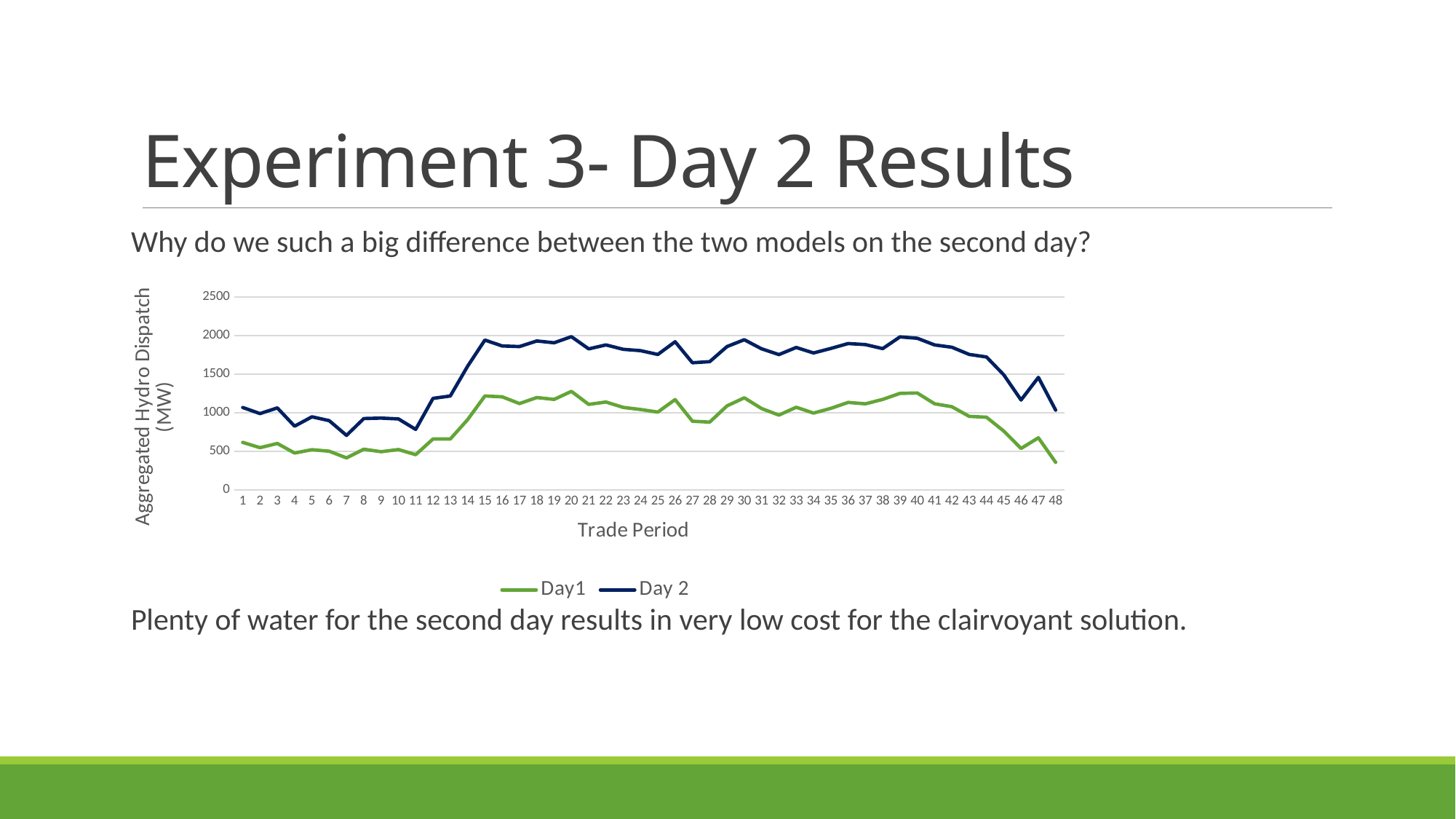
How many trade periods are plotted along the x axis? 48 What is the label of the chart's x axis? Trade Period How many series does the chart's legend list? 2 What kind of chart is shown on the slide? Line chart Is the Day 2 value at trade period 15 greater or less than 1500? greater Is the Day1 value at trade period 7 greater or less than 500? less Does the Day1 series rise or fall between trade period 11 and trade period 15? Rise Which series has the higher value at trade period 20, Day1 or Day 2? Day 2 Is the Day1 value at trade period 20 greater or less than 1000? greater What is the label of the chart's y axis? Aggregated Hydro Dispatch (MW)